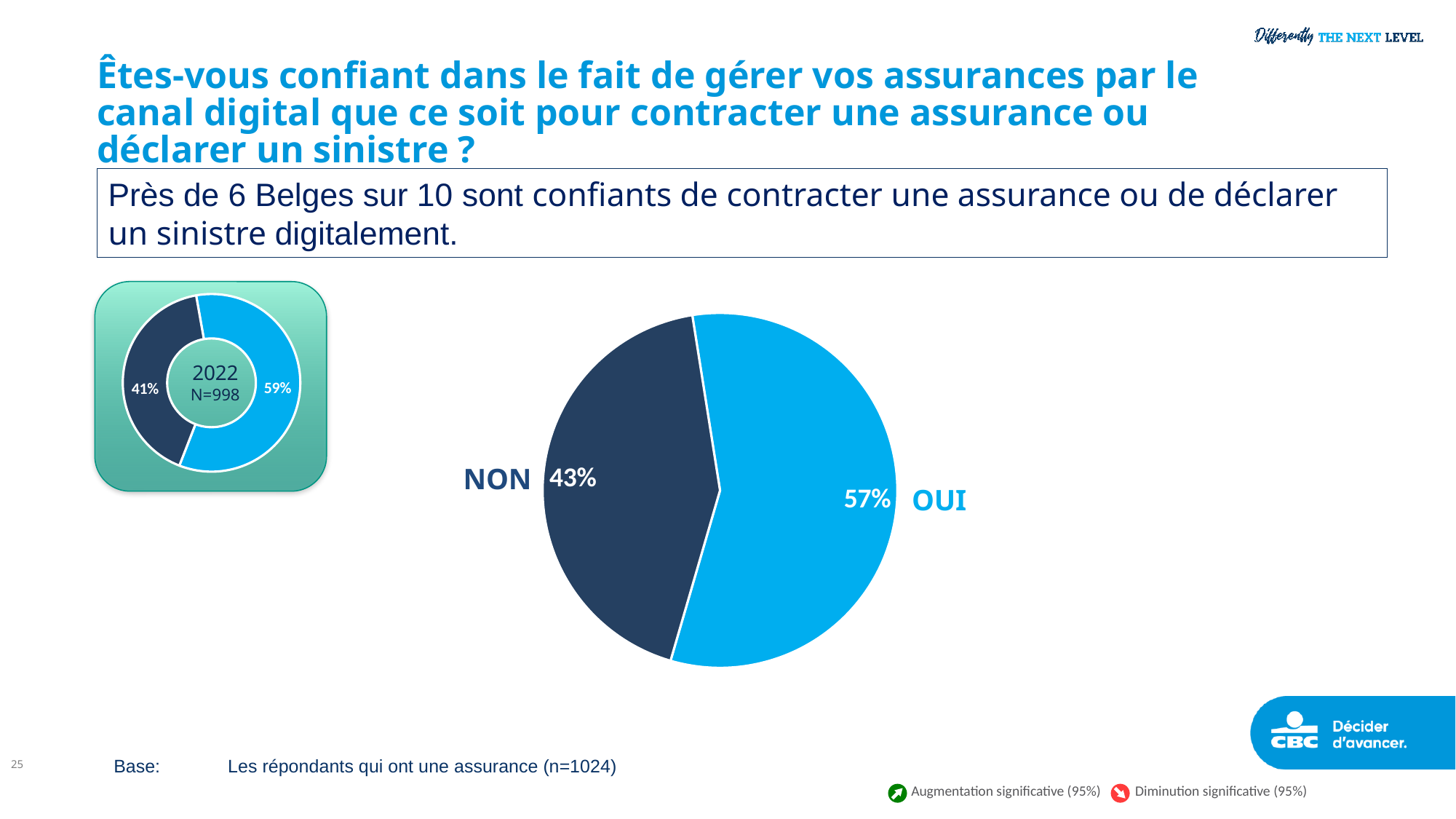
On the small donut chart on the left, what value is shown on the light blue segment? 59% On the large pie chart, which category has the largest share? OUI On the small donut chart on the left, what value is shown on the dark blue segment? 41% What kind of chart is the large chart in the centre of the slide? Pie chart On the large pie chart, what is the value for NON? 43% What year and sample size are shown in the centre of the small donut chart on the left? 2022, N=998 How many slices does the large pie chart have? 2 On the large pie chart, what is the difference between the OUI and NON shares? 14% On the large pie chart, what is the value for OUI? 57% On the large pie chart, which is larger, OUI or NON? OUI On the large pie chart, what colour is the OUI slice? Light blue On the large pie chart, which category has the smallest share? NON